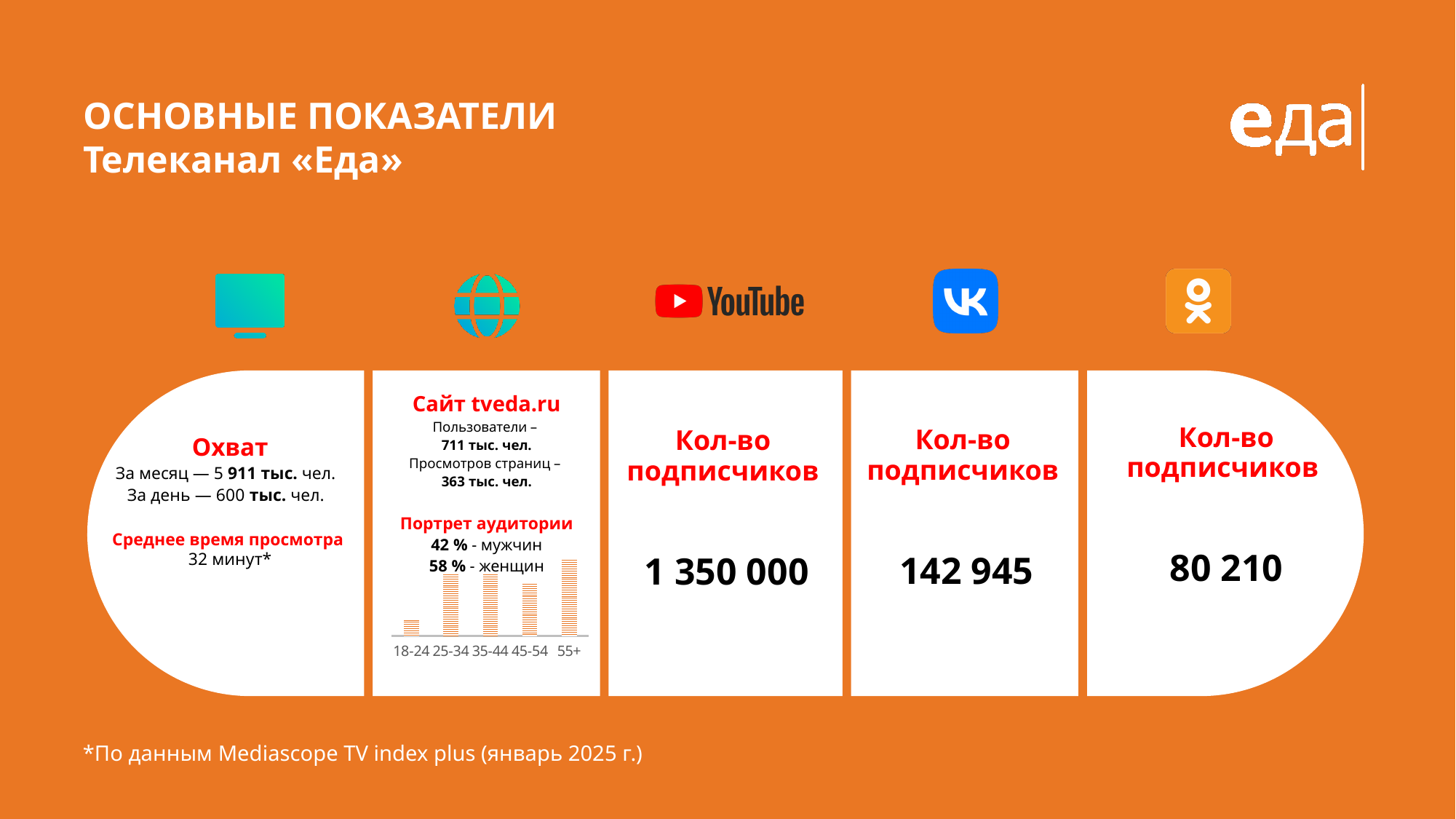
In the «Портрет аудитории» chart, does the bar height rise or fall from 18-24 to 25-34? rise In the «Портрет аудитории» chart, which bar is taller: 18-24 or 55+? 55+ What is the first age category listed on the x axis of the «Портрет аудитории» chart? 18-24 Which age category has the highest bar in the «Портрет аудитории» chart? 55+ In the «Портрет аудитории» chart, which bar is taller: 25-34 or 18-24? 25-34 How many age categories are shown on the x axis of the bar chart in the «Портрет аудитории» section? 5 Which age category has the lowest bar in the «Портрет аудитории» chart? 18-24 In the «Портрет аудитории» chart, which bar is taller: 18-24 or 45-54? 45-54 What colour are the bars in the «Портрет аудитории» chart? orange What kind of chart is shown in the «Портрет аудитории» section of the slide? bar chart